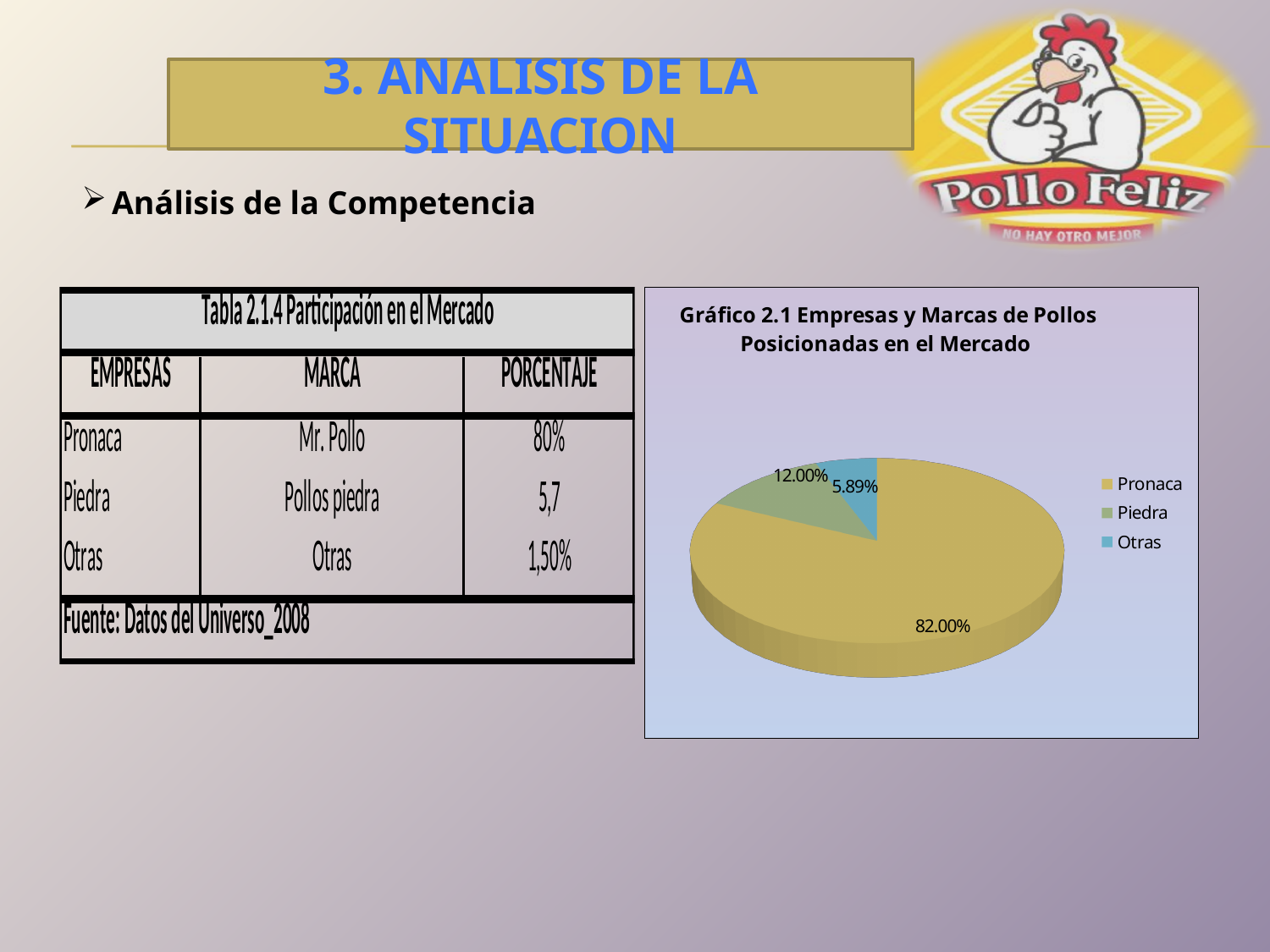
What is the difference between the Pronaca and Piedra values in the pie chart? 70.00% What is the value shown for Piedra in the pie chart? 12.00% What kind of chart is shown on the slide? pie chart What is the value shown for Pronaca in the pie chart? 82.00% What is the difference between the Piedra and Otras values in the pie chart? 6.11% How many entries does the chart legend list? 3 How many slices does the pie chart have? 3 Which is larger in the pie chart, Piedra or Otras? Piedra What is the title of the chart? Gráfico 2.1 Empresas y Marcas de Pollos Posicionadas en el Mercado Which category has the largest slice of the pie chart? Pronaca Which category has the smallest slice of the pie chart? Otras What is the value shown for Otras in the pie chart? 5.89%